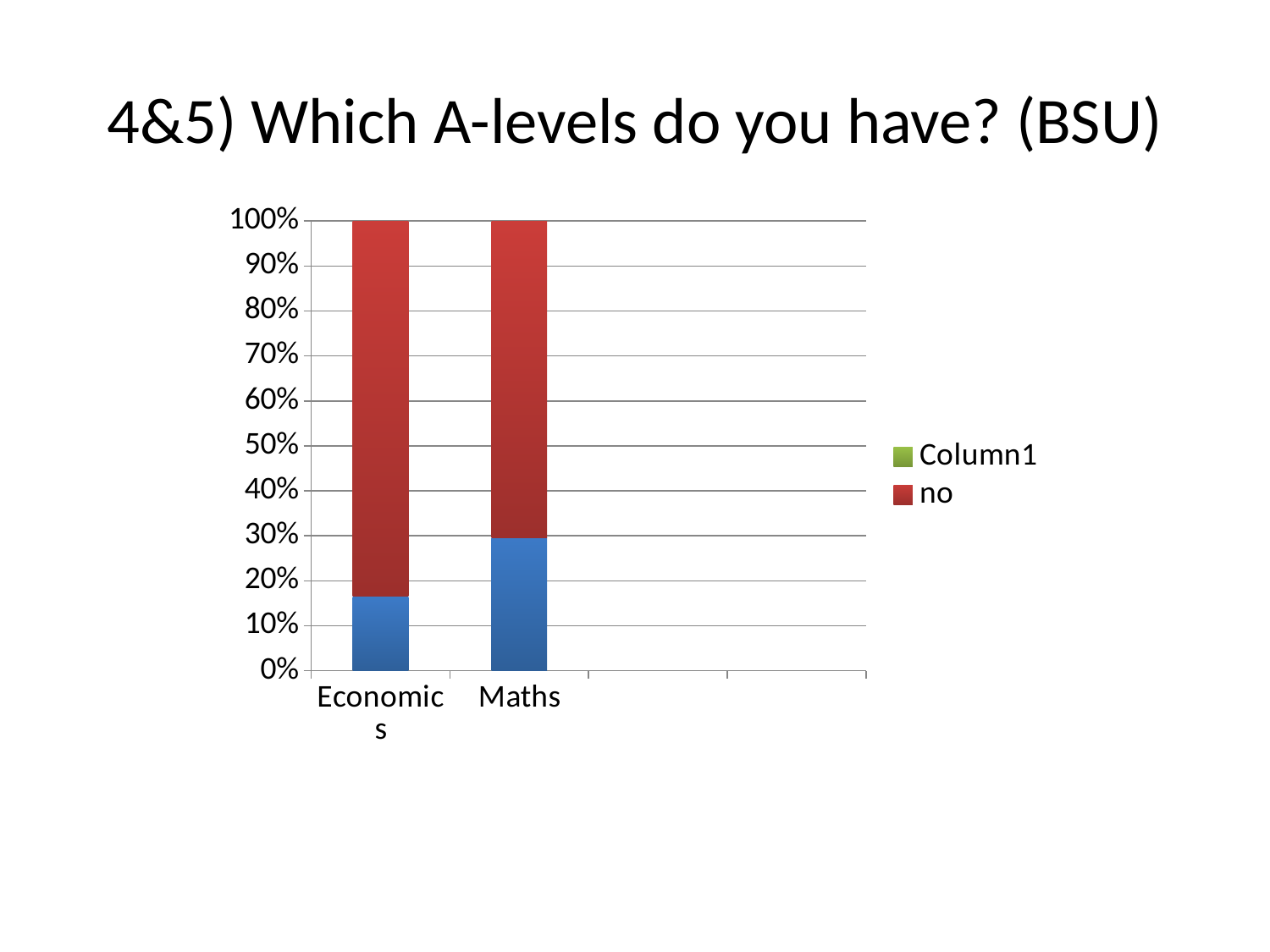
Is the 'no' segment for Economics greater or less than 70%? greater What kind of chart is shown on the slide? stacked bar chart How many series does the chart's legend list? 2 Which legend entry is shown in red? no Which category has the larger blue segment, Economics or Maths? Maths Is the blue segment for Economics greater or less than 20%? less What is the total height of the Economics stacked bar? 100% Which category has the larger 'no' share? Economics How many categories are shown on the x axis of the chart? 2 Is the blue segment for Maths greater or less than 20%? greater What is the title of the slide containing the chart? 4&5) Which A-levels do you have? (BSU)